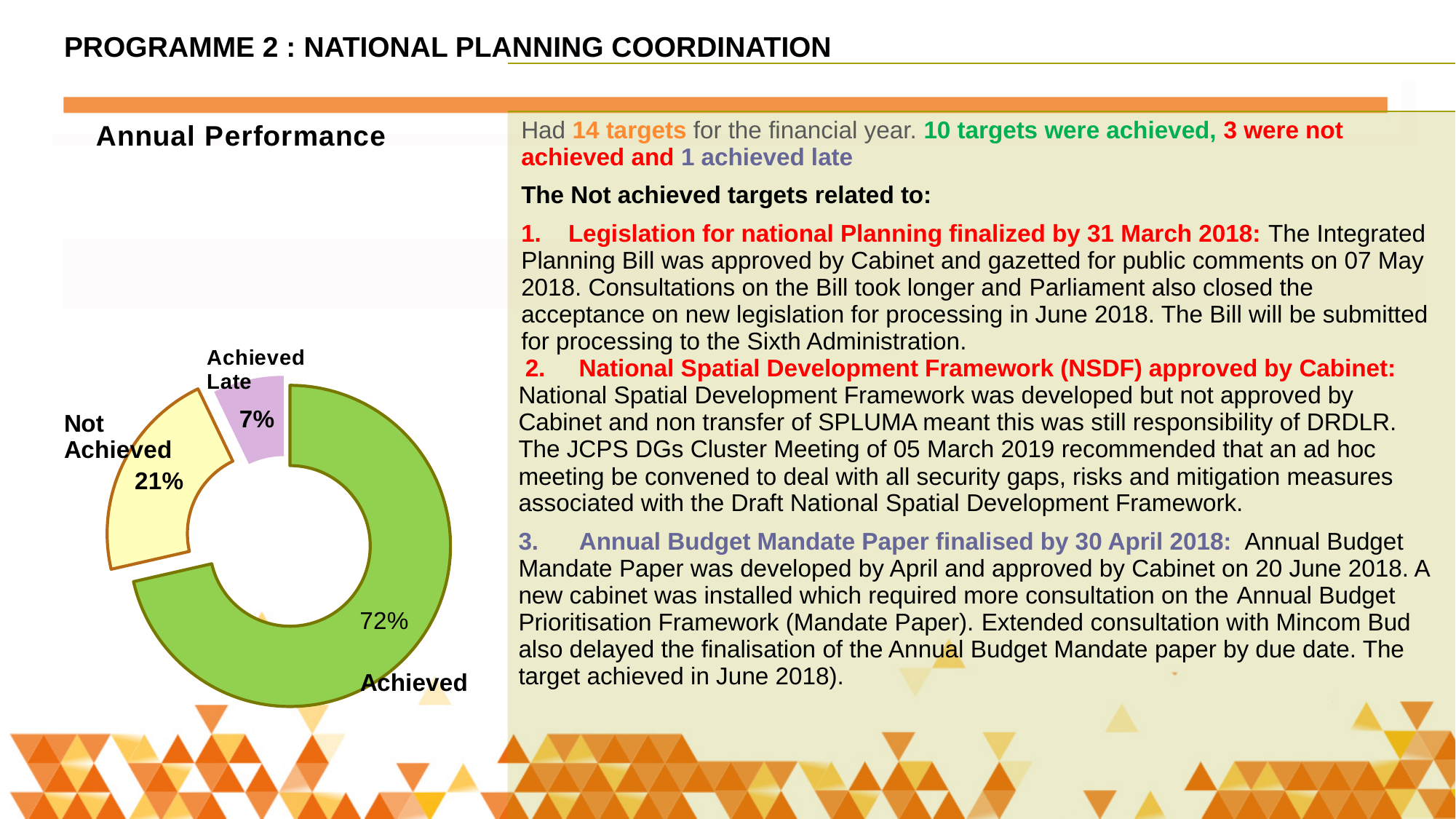
Which is larger, the share for Not Achieved or the share for Achieved Late? Not Achieved What is the difference in percentage points between Not Achieved and Achieved Late? 14 What percentage of targets were Achieved according to the chart? 72% Which category has the smallest share of the chart? Achieved Late How many categories does the chart show? 3 What colour is the Achieved segment of the chart? Green What is the difference in percentage points between Achieved and Not Achieved? 51 What kind of chart is shown on the slide? Doughnut (pie) chart What percentage of targets were Not Achieved according to the chart? 21% What percentage of targets were Achieved Late according to the chart? 7% Which category has the largest share of the chart? Achieved What is the heading above the chart? Annual Performance